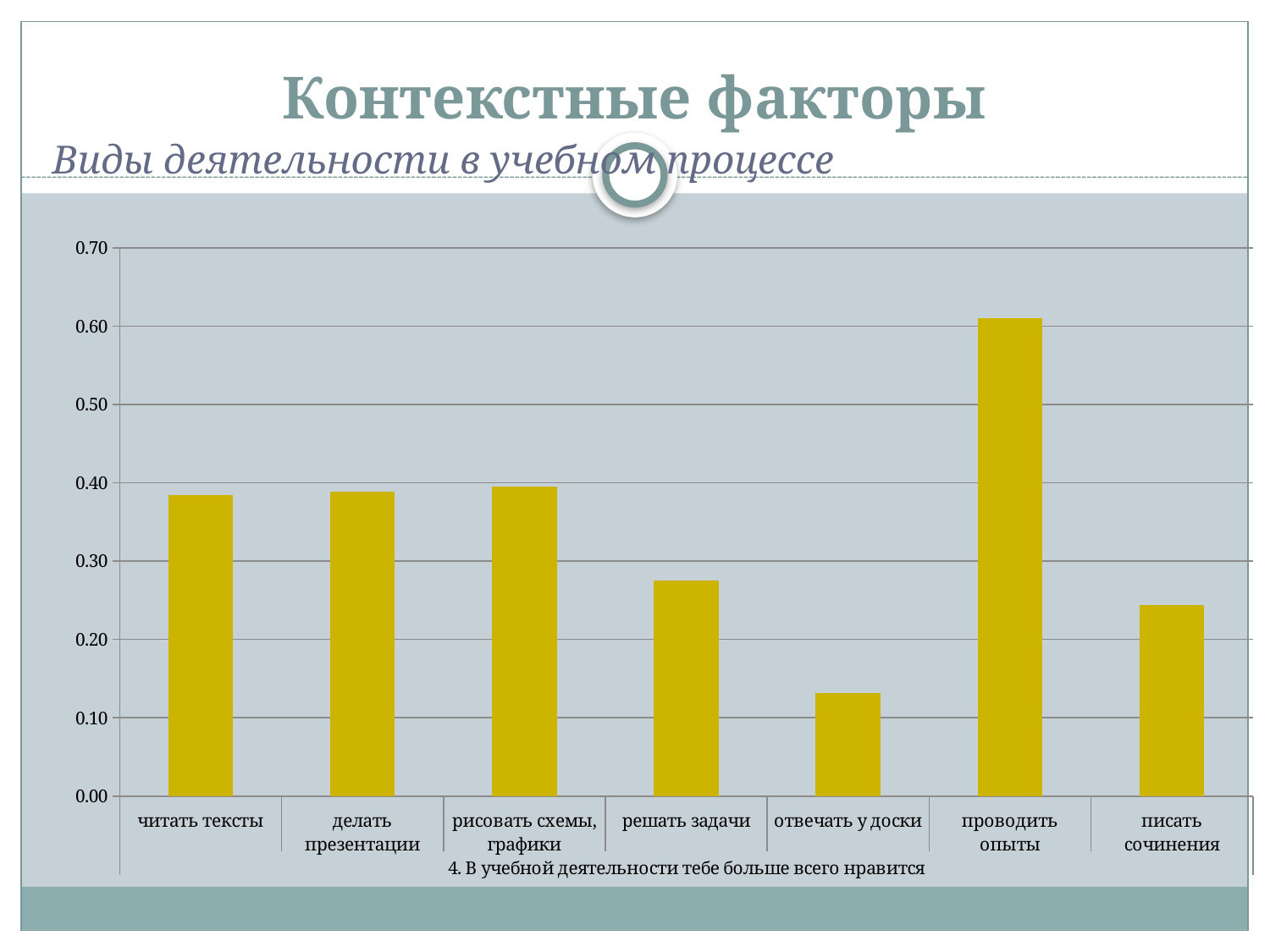
What kind of chart is shown on the slide? bar chart What is the x-axis title of the chart? 4. В учебной деятельности тебе больше всего нравится Is the value for писать сочинения greater or less than 0.20? greater Is the value for отвечать у доски greater or less than 0.20? less Which is larger, the value for писать сочинения or the value for отвечать у доски? писать сочинения Which category has the highest value in the chart? проводить опыты Is the value for решать задачи greater or less than 0.30? less Which is larger, the value for проводить опыты or the value for решать задачи? проводить опыты Which category has the lowest value in the chart? отвечать у доски How many categories are shown on the x axis of the chart? 7